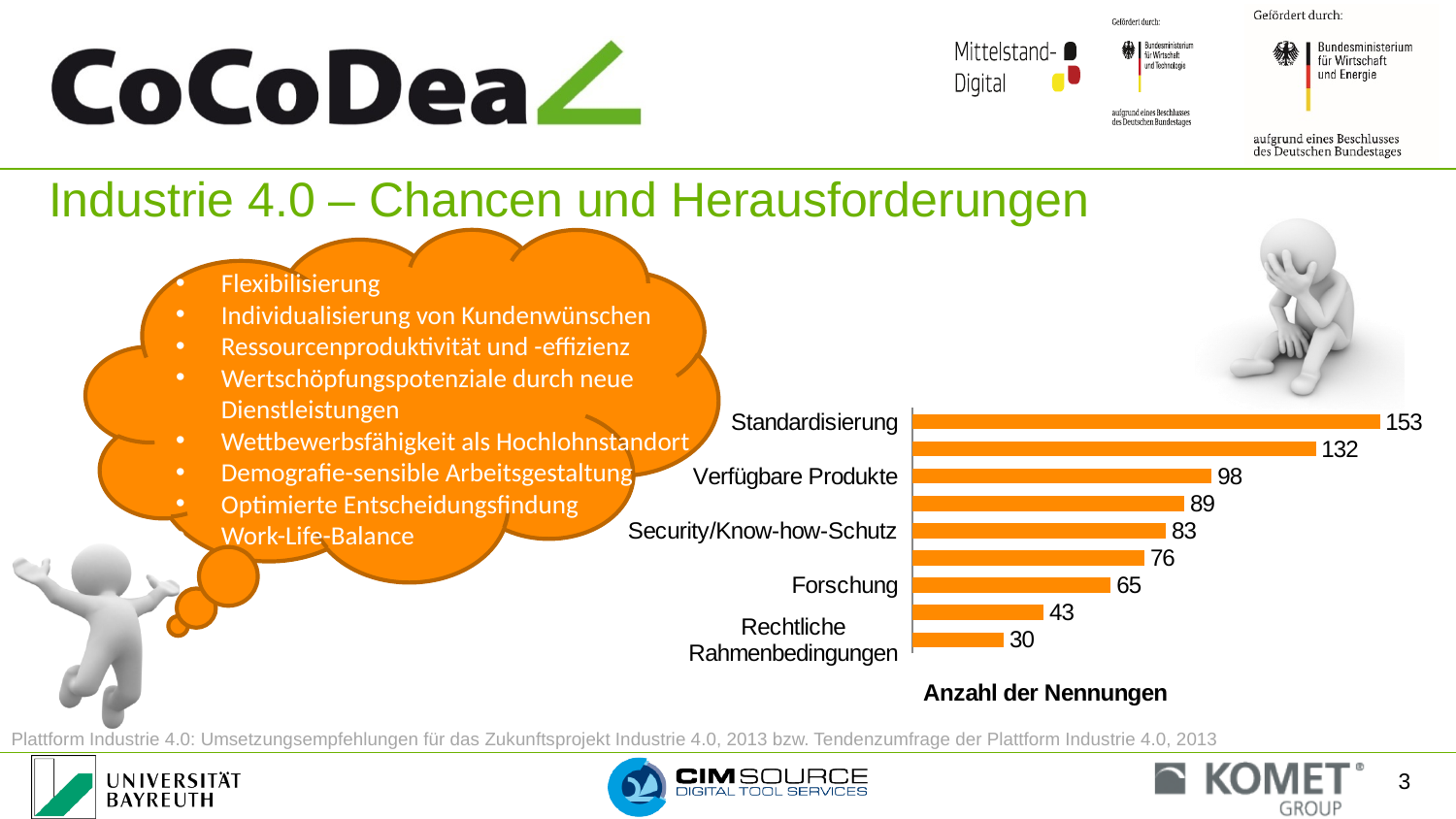
What kind of chart is shown on the slide? bar chart Which is larger, the value for Verfügbare Produkte or the value for Forschung? Verfügbare Produkte What is the value for Security/Know-how-Schutz? 83 Which category has the highest value? Standardisierung What is the value for Rechtliche Rahmenbedingungen? 30 What is the value for Verfügbare Produkte? 98 What is the value for Standardisierung? 153 Which category has the lowest value? Rechtliche Rahmenbedingungen How many bars are plotted in the chart? 9 What is the value for Forschung? 65 What is the difference between the values for Standardisierung and Rechtliche Rahmenbedingungen? 123 What is the axis title shown below the bars? Anzahl der Nennungen